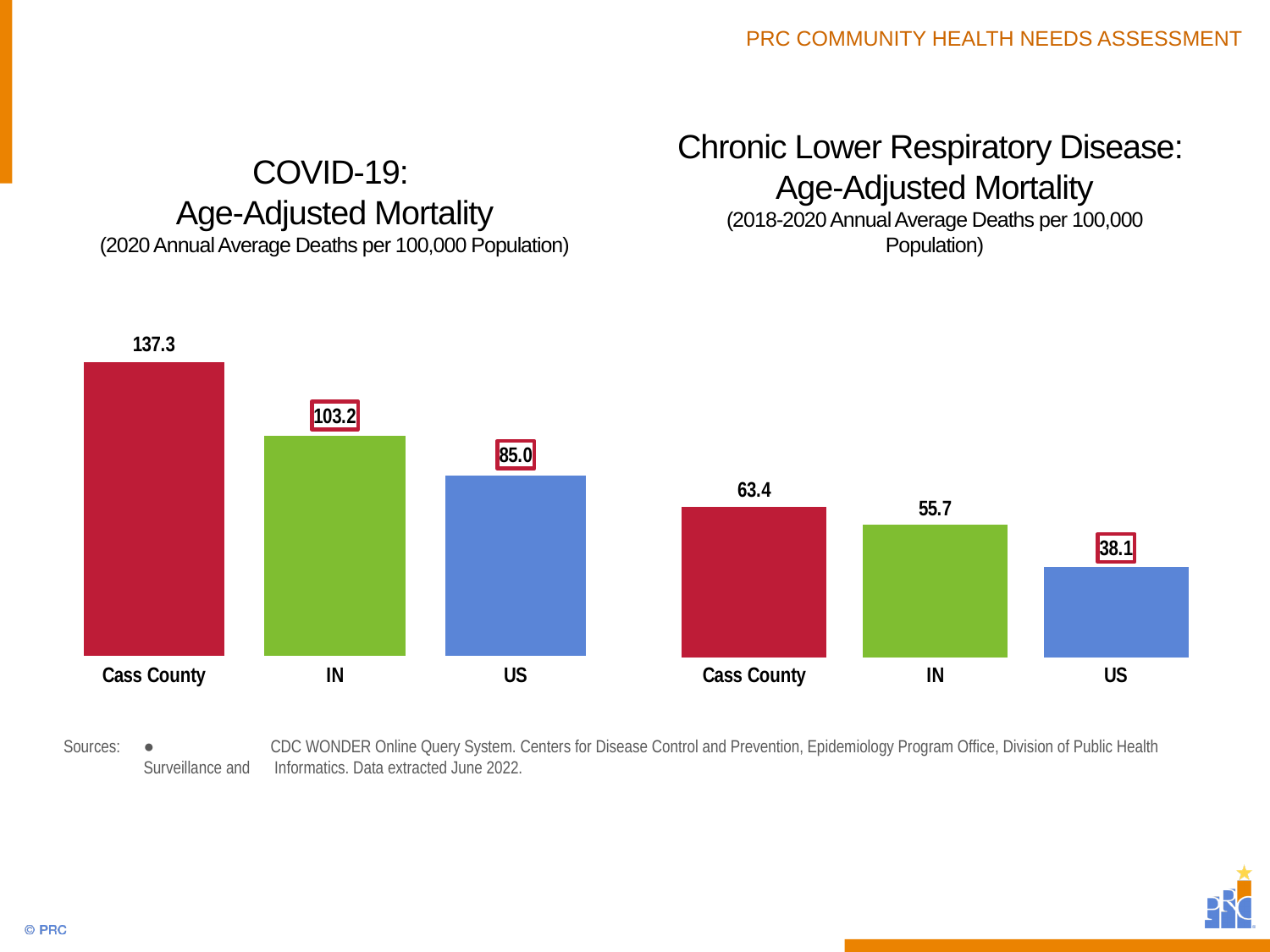
In the Chronic Lower Respiratory Disease: Age-Adjusted Mortality chart, what is the value for IN? 55.7 In the Chronic Lower Respiratory Disease: Age-Adjusted Mortality chart, what is the value for US? 38.1 In the Chronic Lower Respiratory Disease: Age-Adjusted Mortality chart, what is the difference between the Cass County value and the IN value? 7.7 In the Chronic Lower Respiratory Disease: Age-Adjusted Mortality chart, which category has the lowest value? US In the COVID-19: Age-Adjusted Mortality chart, which category has the highest value? Cass County How many categories are shown in the COVID-19: Age-Adjusted Mortality chart? 3 In the COVID-19: Age-Adjusted Mortality chart, what is the value for Cass County? 137.3 In the COVID-19: Age-Adjusted Mortality chart, what is the difference between the Cass County value and the US value? 52.3 In the COVID-19: Age-Adjusted Mortality chart, what is the value for IN? 103.2 What kind of chart is the Chronic Lower Respiratory Disease: Age-Adjusted Mortality chart? Bar chart In the Chronic Lower Respiratory Disease: Age-Adjusted Mortality chart, which is larger, the value for IN or the value for US? IN In the COVID-19: Age-Adjusted Mortality chart, do the values rise or fall from Cass County to US? Fall